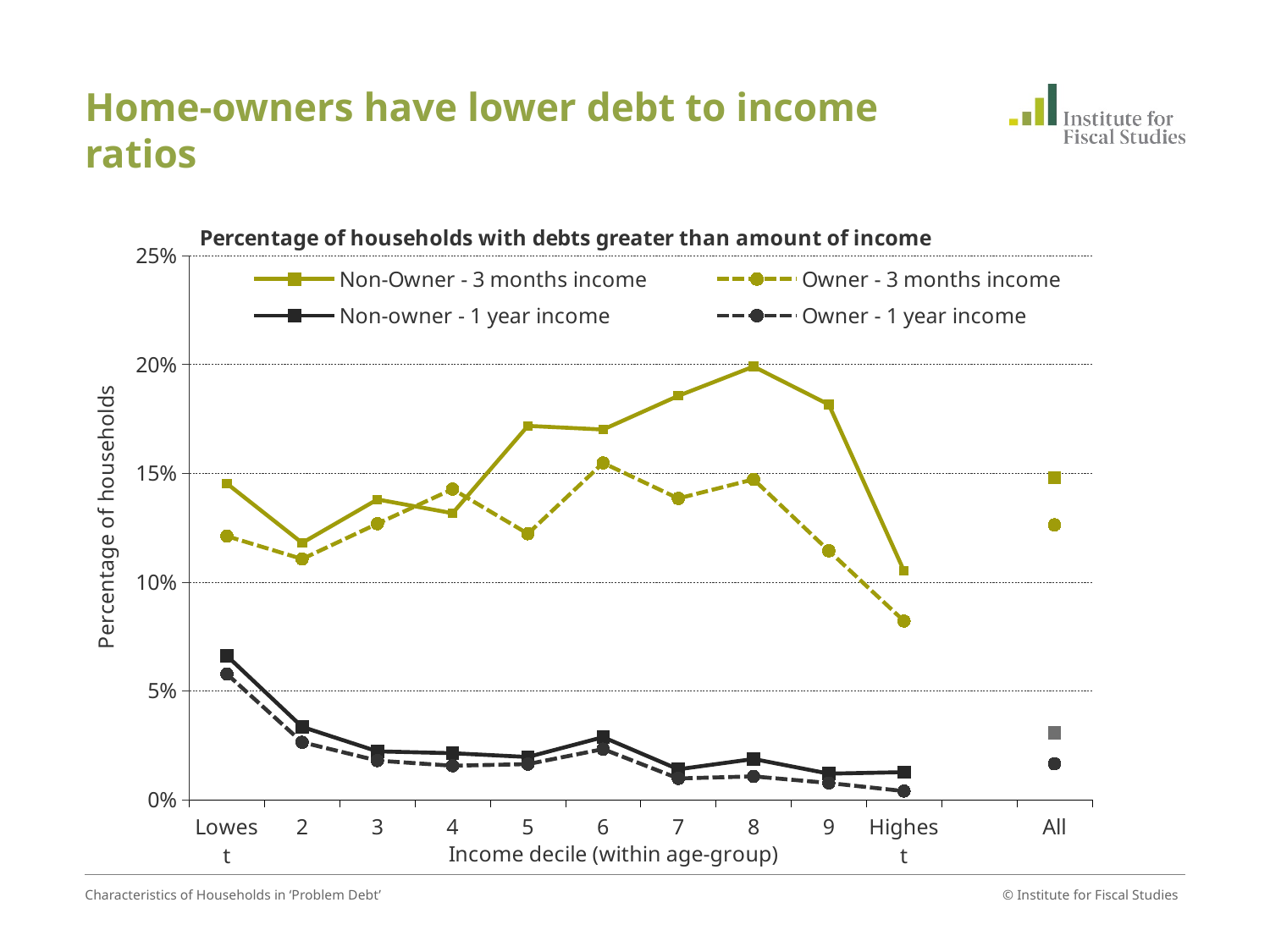
At which income decile does the Non-Owner - 3 months income series reach its highest value? 8 Is the value for Non-Owner - 3 months income at decile 7 greater or less than 15%? greater What kind of chart is shown on the slide? Line chart At the Lowest decile, which is larger: Non-Owner - 3 months income or Owner - 3 months income? Non-Owner - 3 months income At decile 4, which is larger: Owner - 3 months income or Non-Owner - 3 months income? Owner - 3 months income Is the value for Non-owner - 1 year income at the Lowest decile greater or less than 5%? greater Is the value for Owner - 3 months income at the Highest decile greater or less than 10%? less How many series does the legend list? 4 What is the title of the chart? Percentage of households with debts greater than amount of income Does the Non-owner - 1 year income series generally rise or fall from the Lowest to the Highest decile? Fall How many categories are shown along the x axis? 11 At which income decile is the Owner - 3 months income series lowest? Highest